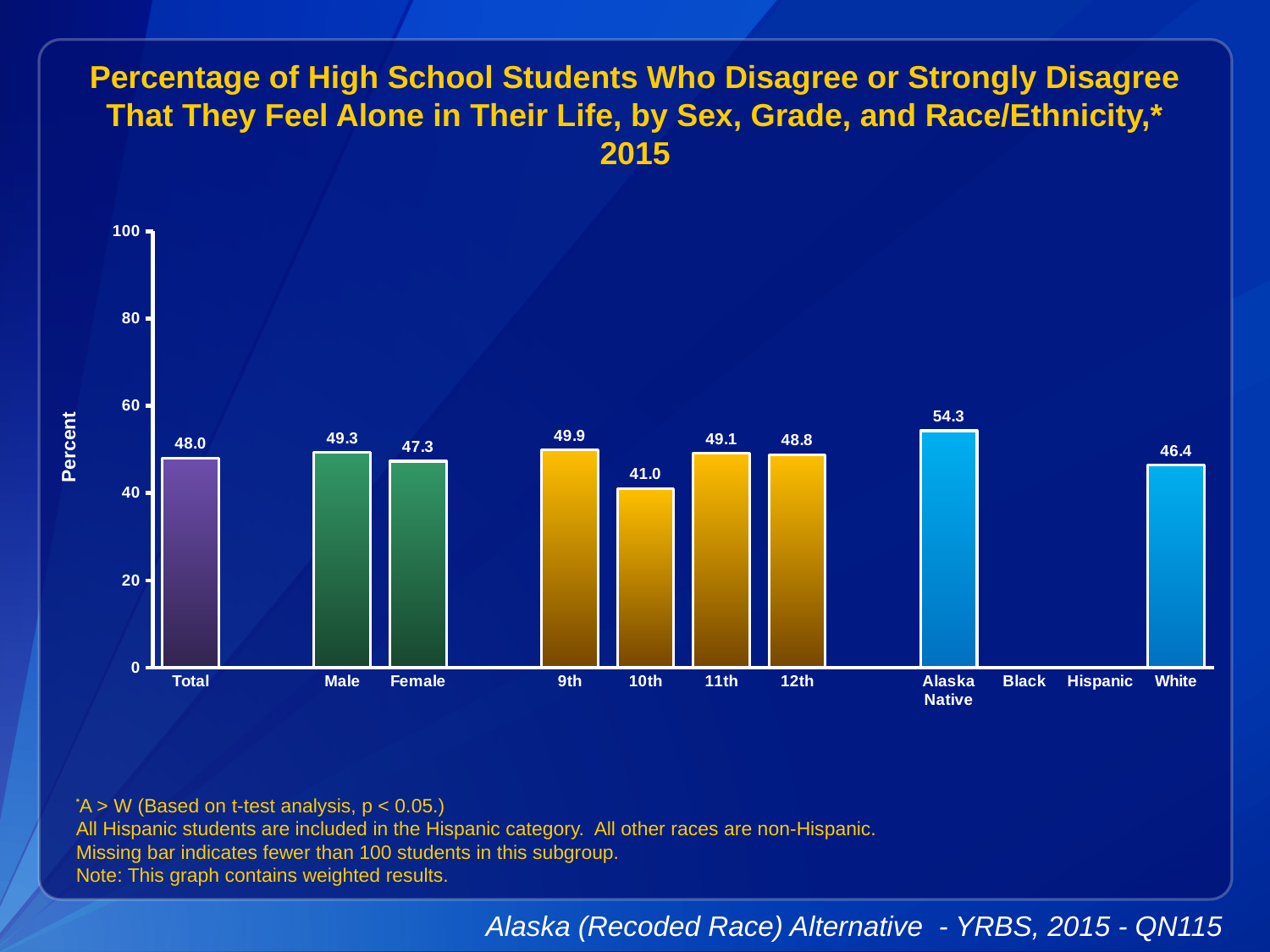
Which category has the lowest value among the bars shown? 10th What is the difference between the values for Male and Female? 2.0 What kind of chart is shown? bar chart What is the difference between the values for Alaska Native and White? 7.9 What is the value for Total? 48.0 Which category has the highest value? Alaska Native What is the value for Male? 49.3 What is the value for Alaska Native? 54.3 What is the value for 10th grade? 41.0 How many bars are plotted on the chart? 9 Is the value for 11th grade greater or less than 40? greater Which is larger, the value for 9th grade or 12th grade? 9th